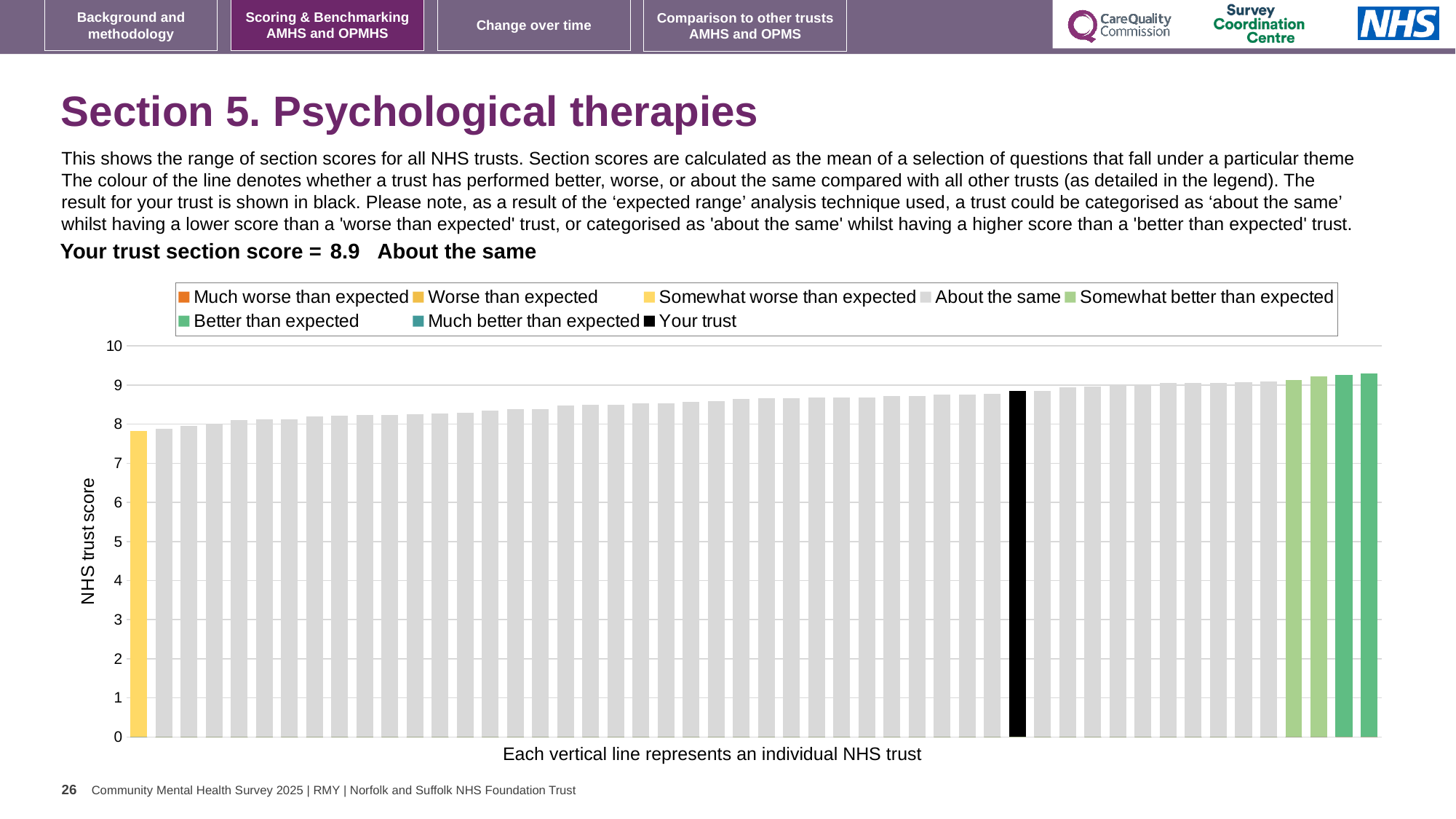
Which is higher: the black bar for your trust or the yellow bar on the far left? The black bar (your trust) How many entries does the chart legend list? 8 What kind of chart is shown on the slide? Bar chart What is the section score for your trust shown on the slide? 8.9 Is the value of the black bar (your trust) greater or less than 8? greater Is the value of the rightmost bar greater or less than 9? greater What is the label on the vertical axis of the chart? NHS trust score Is the value of the leftmost (yellow) bar greater or less than 8? less How many bars are coloured as 'Somewhat worse than expected'? 1 How many bars are coloured as 'Better than expected'? 2 Do the bar values rise or fall from left to right along the x axis? rise Which category is your trust placed in for this section? About the same